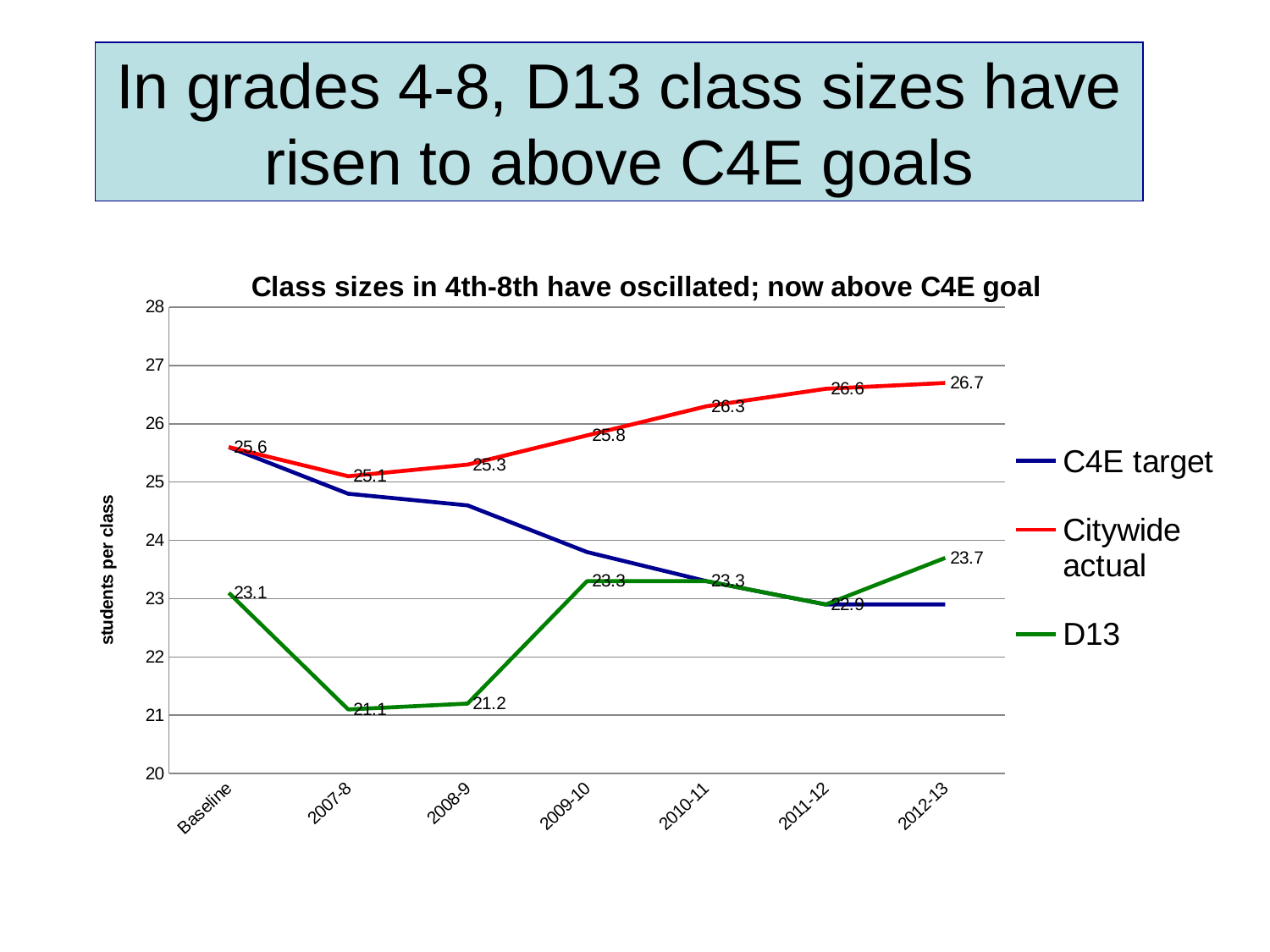
How many series does the legend list? 3 What is the label on the y axis of the chart? students per class Does the Citywide actual series rise or fall from 2008-9 to 2012-13? rise Which is larger for D13: the value in 2011-12 or the value in 2012-13? 2012-13 How many points are plotted along the x axis for each series? 7 Is the C4E target value for 2009-10 greater or less than 24? less In which year does the D13 series reach its highest value? 2012-13 What kind of chart is shown on the slide? line chart What is the D13 value for 2007-8? 21.1 In which year does the D13 series reach its lowest value? 2007-8 What is the Citywide actual value for 2012-13? 26.7 How much higher is the Citywide actual value in 2012-13 than at Baseline? 1.1